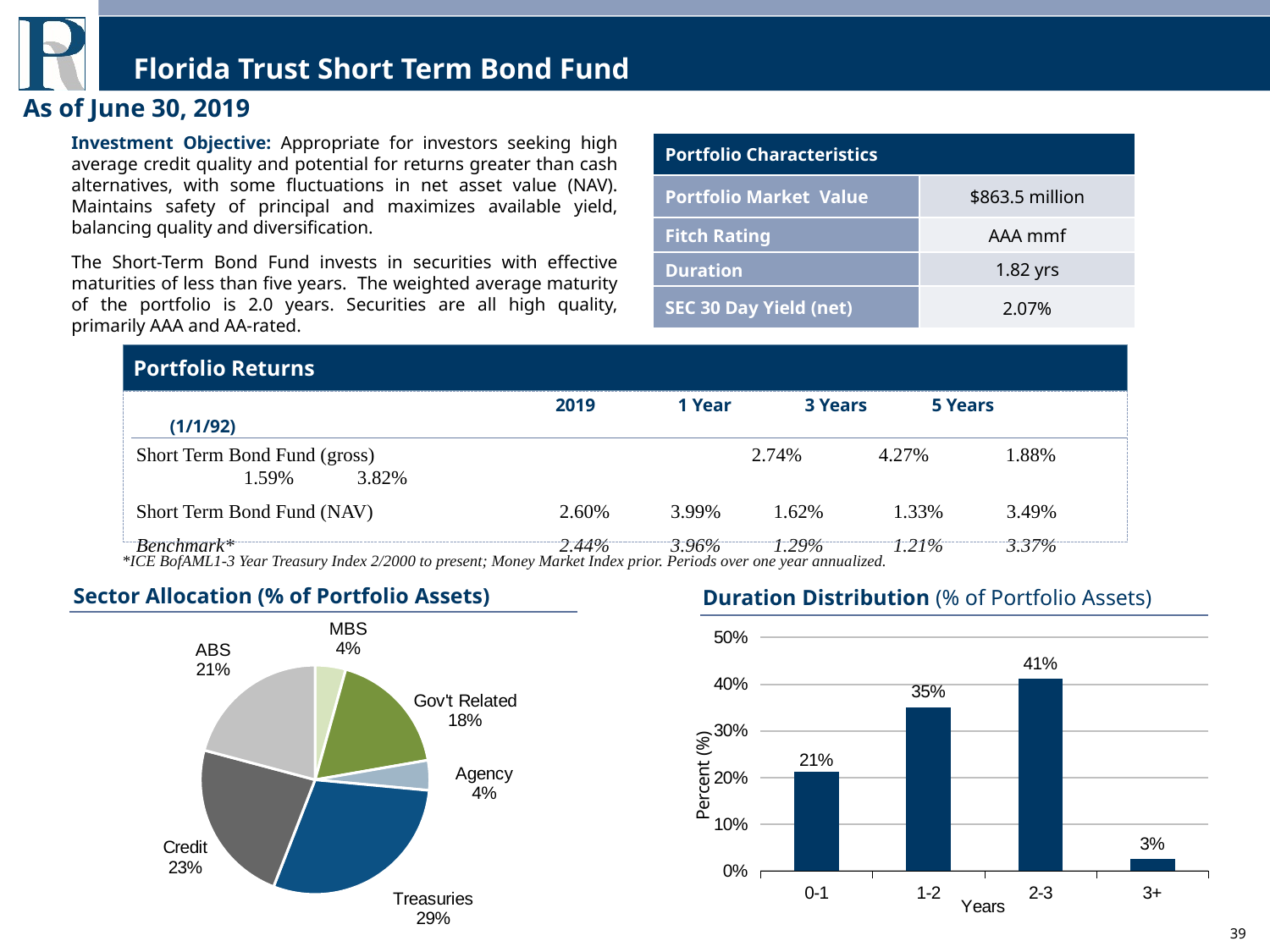
In the Duration Distribution chart, what is the value for the 2-3 years category? 41% In the Sector Allocation pie chart, what share of portfolio assets is in Treasuries? 29% What kind of chart is the Duration Distribution chart? Bar chart In the Sector Allocation pie chart, which sector has the largest share? Treasuries What kind of chart is the Sector Allocation chart? Pie chart In the Sector Allocation pie chart, how many sectors are shown? 6 In the Duration Distribution chart, how many duration categories are shown? 4 In the Duration Distribution chart, which duration category has the lowest value? 3+ In the Duration Distribution chart, what is the label on the x axis? Years In the Sector Allocation pie chart, which is larger, ABS or Credit? Credit In the Duration Distribution chart, what is the difference between the 1-2 years and 0-1 years values? 14% In the Sector Allocation pie chart, what is the difference between the Credit share and the Gov't Related share? 5%